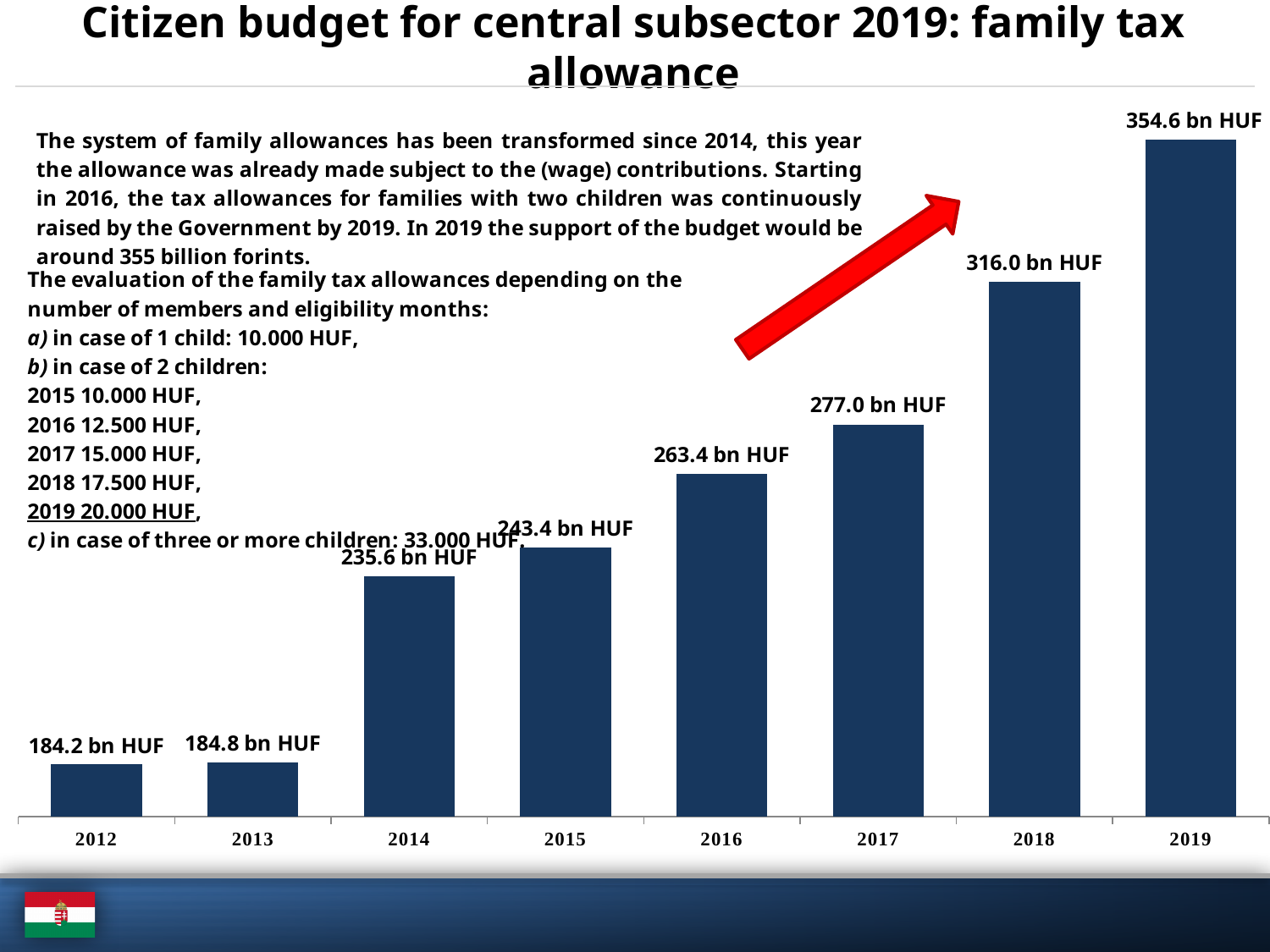
What is the value for 2014? 235.6 bn HUF Which year has the lowest value? 2012 Do the values rise or fall from 2012 to 2019? Rise How many years are shown on the x axis? 8 Which is larger, the value for 2018 or the value for 2017? 2018 What is the value for 2019? 354.6 bn HUF What is the difference between the values for 2016 and 2015? 20.0 bn HUF What kind of chart is shown on the slide? Bar chart What is the value for 2012? 184.2 bn HUF What is the value for 2017? 277.0 bn HUF Which year has the highest value? 2019 What is the difference between the values for 2019 and 2018? 38.6 bn HUF